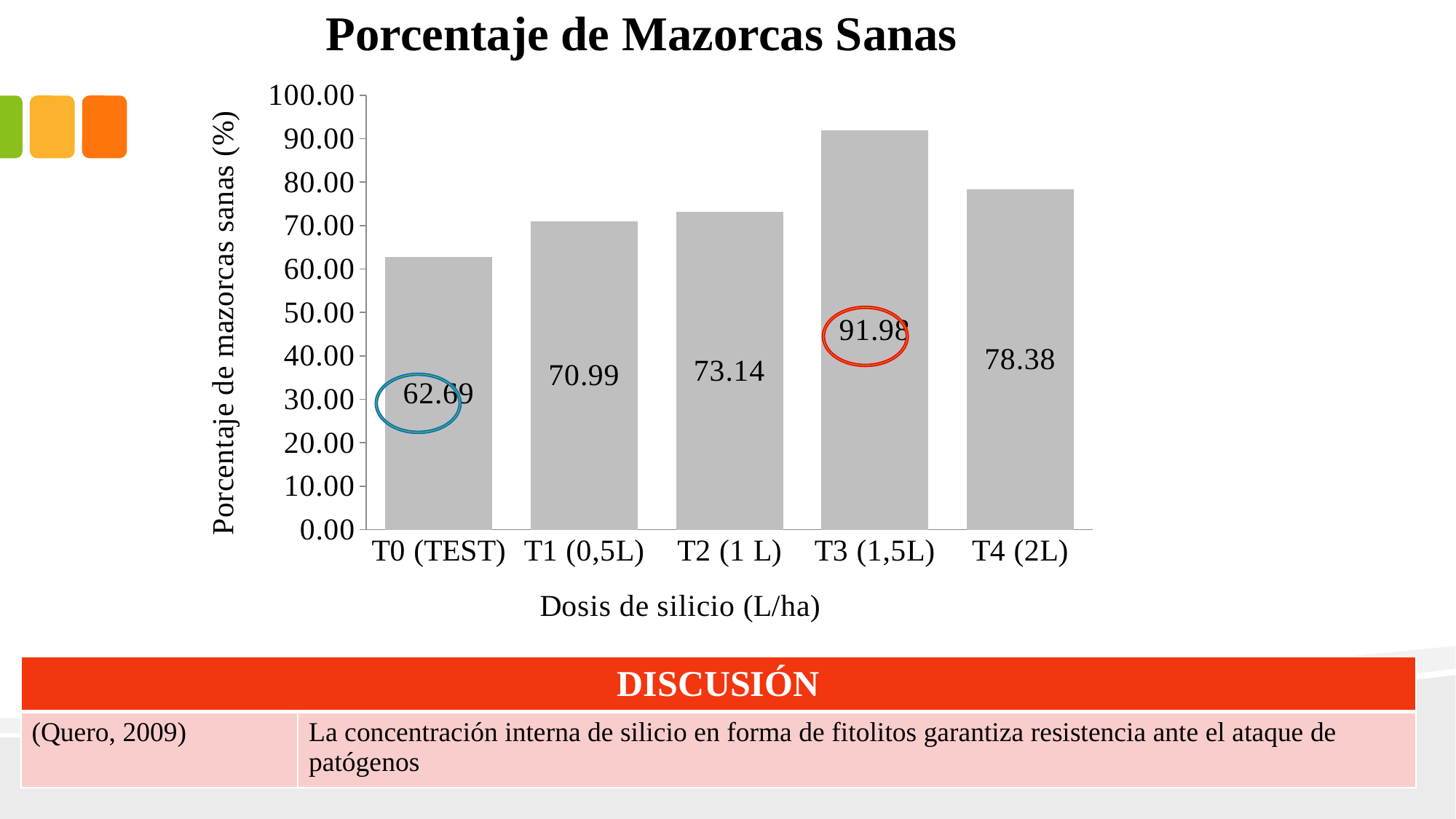
What is the value for T0 (TEST)? 62.69 What kind of chart is shown on the slide? bar chart Which category has the highest percentage of healthy cobs? T3 (1,5L) Is the value for T3 (1,5L) greater or less than 90.00? greater Which is larger, the value for T2 (1 L) or the value for T4 (2L)? T4 (2L) What is the value for T4 (2L)? 78.38 What is the value for T1 (0,5L)? 70.99 What is the title of the chart? Porcentaje de Mazorcas Sanas What is the value for T3 (1,5L)? 91.98 What is the difference between the values for T3 (1,5L) and T0 (TEST)? 29.29 Which category has the lowest percentage of healthy cobs? T0 (TEST) How many categories are shown on the x axis? 5